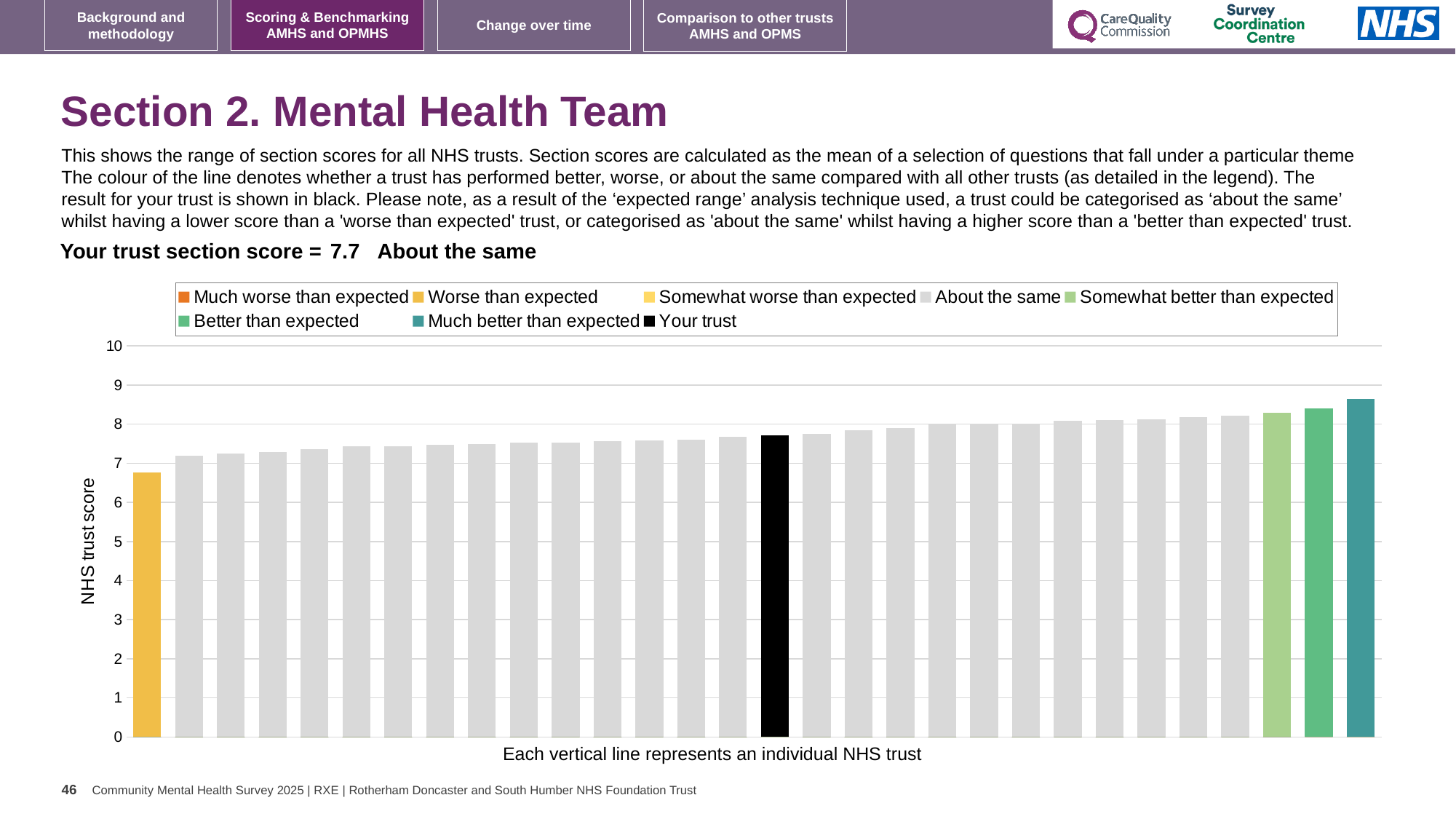
What is the label on the y axis of the chart? NHS trust score What colour is the bar representing your trust? black Which legend category does the lowest bar in the chart belong to? Worse than expected How many entries does the chart legend list? 8 Is the value of the black bar for your trust greater or less than 8? less How many bars (NHS trusts) are plotted in the chart? 30 Is the value of the lowest bar (the leftmost, yellow bar) greater or less than 7? less Do the bar values rise or fall moving from left to right along the x axis? rise Which legend category does the highest bar in the chart belong to? Much better than expected What is the section score for your trust shown on the slide? 7.7 What kind of chart is shown on the slide? bar chart Is the value of the highest bar (the rightmost, teal bar) greater or less than 8? greater